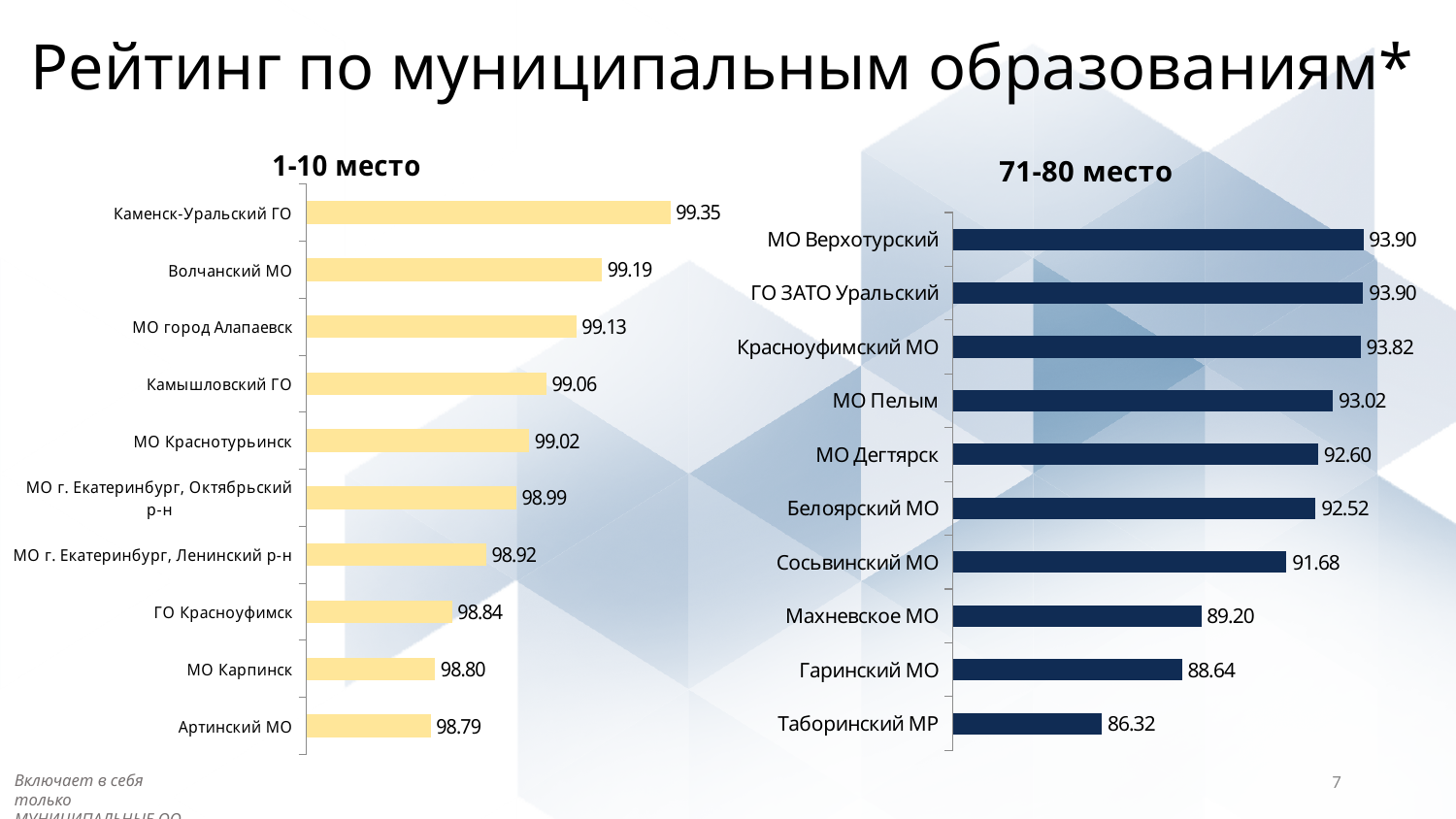
In the "71-80 место" chart, what is the value for Таборинский МР? 86.32 What kind of chart is the "1-10 место" chart? Bar chart In the "71-80 место" chart, what is the difference between the values for Махневское МО and Гаринский МО? 0.56 In the "71-80 место" chart, what is the value for Сосьвинский МО? 91.68 In the "1-10 место" chart, what is the value for МО Карпинск? 98.80 In the "71-80 место" chart, which is larger: the value for МО Пелым or the value for МО Дегтярск? МО Пелым In the "1-10 место" chart, which category has the lowest value? Артинский МО In the "71-80 место" chart, which category has the lowest value? Таборинский МР What colour are the bars in the "71-80 место" chart? Dark blue In the "1-10 место" chart, what is the value for Каменск-Уральский ГО? 99.35 How many categories are shown in the "71-80 место" chart? 10 In the "1-10 место" chart, what is the difference between the values for Каменск-Уральский ГО and Артинский МО? 0.56